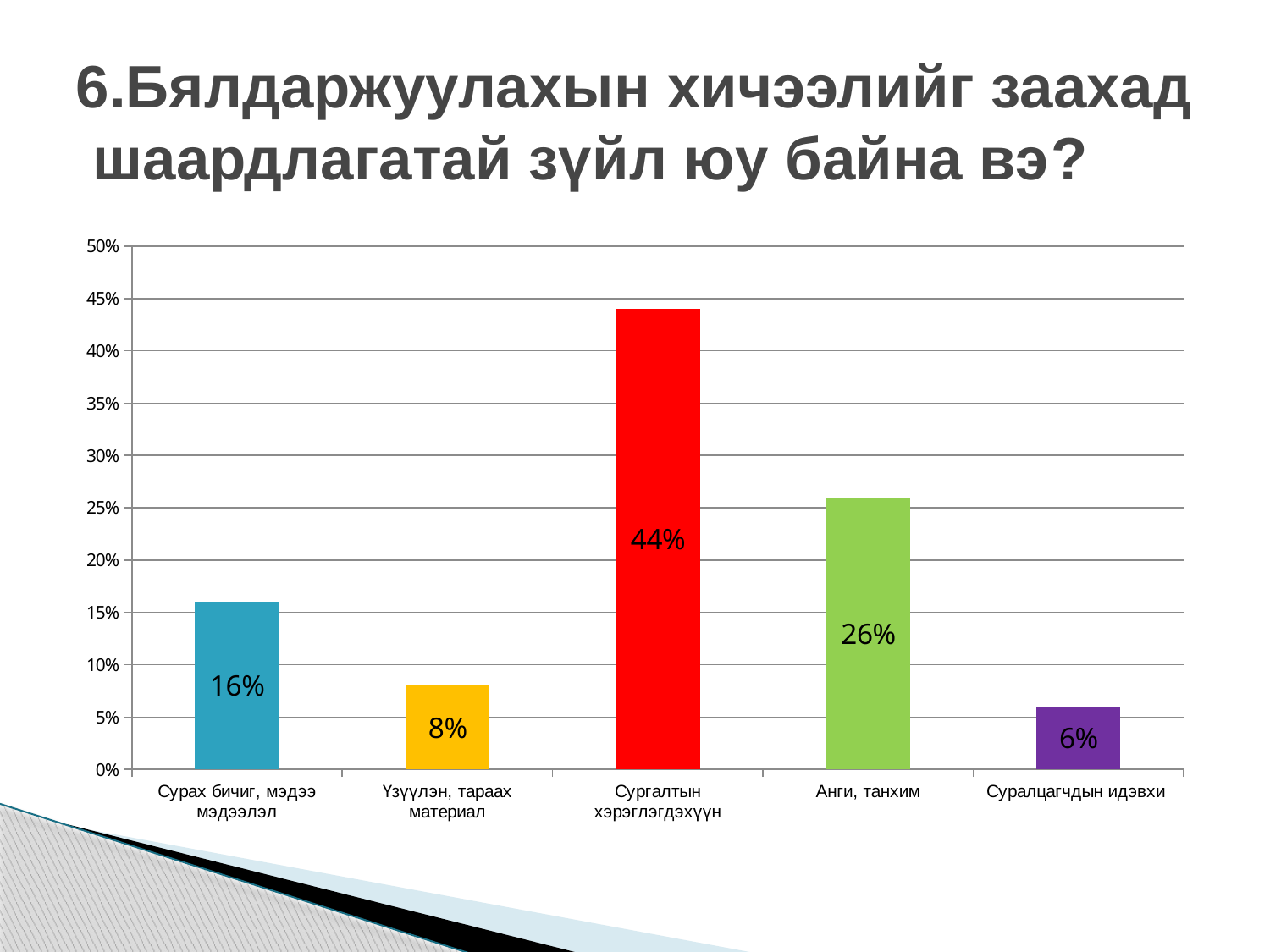
What kind of chart is shown on the slide? bar chart Which category has the highest value? Сургалтын хэрэглэгдэхүүн What is the value for Үзүүлэн, тараах материал? 8% What colour is the bar for Сургалтын хэрэглэгдэхүүн? red Which is larger, the value for Сурах бичиг, мэдээ мэдээлэл or the value for Үзүүлэн, тараах материал? Сурах бичиг, мэдээ мэдээлэл What is the difference between the values for Сургалтын хэрэглэгдэхүүн and Анги, танхим? 18% What is the value for Анги, танхим? 26% Is the value for Анги, танхим greater or less than 30%? less What is the value for Суралцагчдын идэвхи? 6% What is the value for Сургалтын хэрэглэгдэхүүн? 44% How many categories are shown on the chart? 5 Which category has the lowest value? Суралцагчдын идэвхи